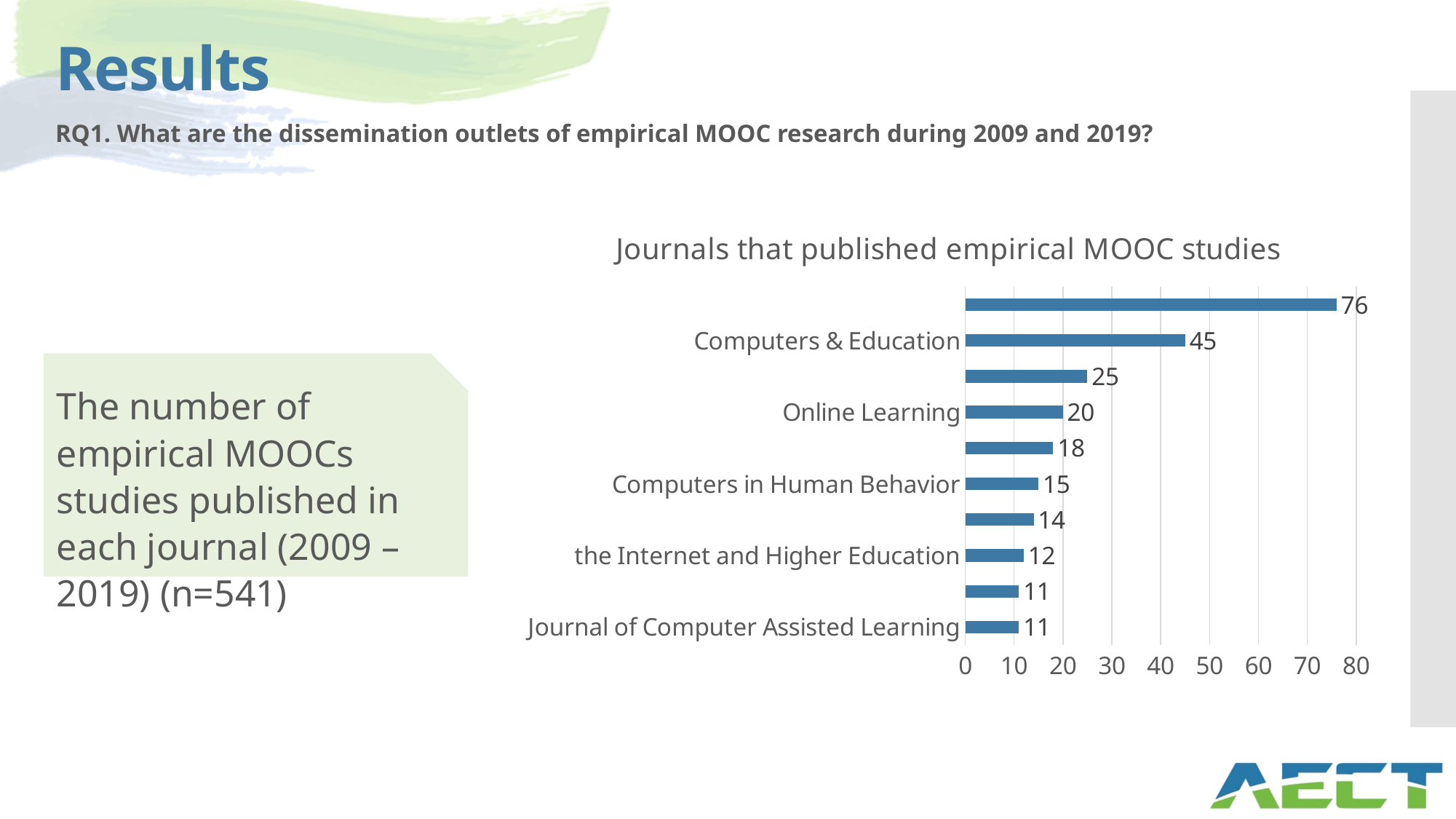
What is the value shown for Journal of Computer Assisted Learning? 11 Which has a larger value, Online Learning or Computers in Human Behavior? Online Learning What type of chart is shown on the slide? bar chart What is the largest value labelled on any bar in the chart? 76 How many bars are plotted in the chart? 10 What is the difference between the values for Computers in Human Behavior and the Internet and Higher Education? 3 What is the value shown for Online Learning? 20 What is the value shown for Computers in Human Behavior? 15 How many empirical MOOC studies were published in Computers & Education? 45 Is the value for Computers & Education greater or less than 40? greater What is the difference between the values for Computers & Education and Online Learning? 25 What is the value shown for the Internet and Higher Education? 12